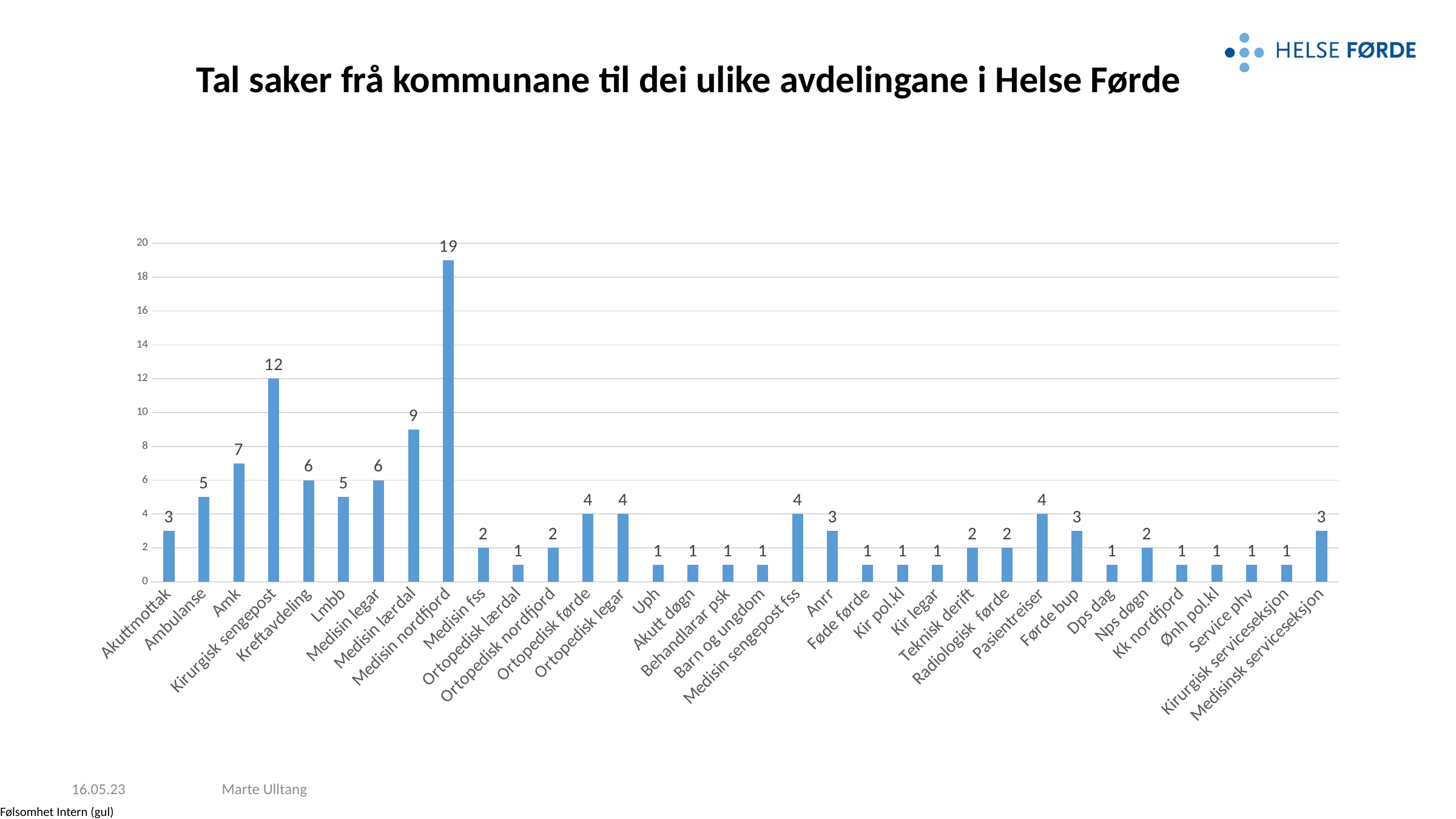
What is the difference between the values for Amk and Akuttmottak? 4 Which is larger, the value for Anrr or the value for Medisin sengepost fss? Medisin sengepost fss What is the title of the chart? Tal saker frå kommunane til dei ulike avdelingane i Helse Førde What is the difference between the values for Medisin nordfjord and Kirurgisk sengepost? 7 What is the value for Medisin lærdal? 9 What is the value for Medisin nordfjord? 19 What is the value for Pasientreiser? 4 Which is larger, the value for Kreftavdeling or the value for Lmbb? Kreftavdeling How many categories are shown on the x axis? 34 What is the value for Kirurgisk sengepost? 12 What kind of chart is shown on the slide? Bar chart Which category has the highest value? Medisin nordfjord